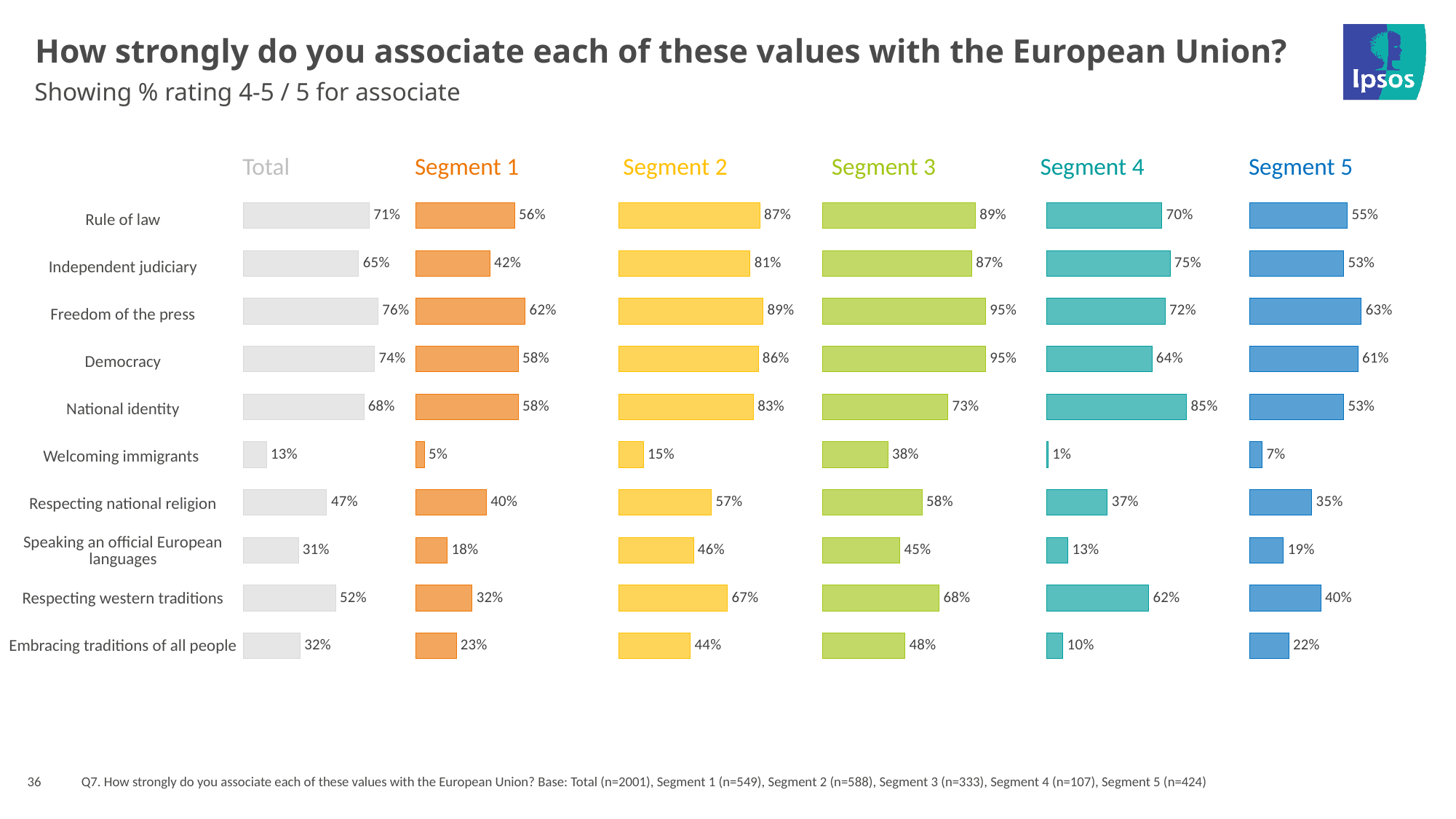
In the Segment 3 chart, what is the value for Welcoming immigrants? 38% In the Segment 4 chart, which is larger: Independent judiciary or Democracy? Independent judiciary In the Segment 4 chart, what is the value for National identity? 85% How many segment charts (excluding Total) are shown on the slide? 5 In the Total chart, what is the value for Freedom of the press? 76% In the Segment 2 chart, what is the value for Embracing traditions of all people? 44% In the Segment 2 chart, which category has the highest value? Freedom of the press In the Segment 1 chart, which category has the lowest value? Welcoming immigrants What kind of chart is used for the Segment 3 data? Bar chart How many categories are shown in the Total chart? 10 In the Segment 5 chart, what is the difference between Freedom of the press and Welcoming immigrants? 56% In the Segment 1 chart, what is the difference between Rule of law and Independent judiciary? 14%